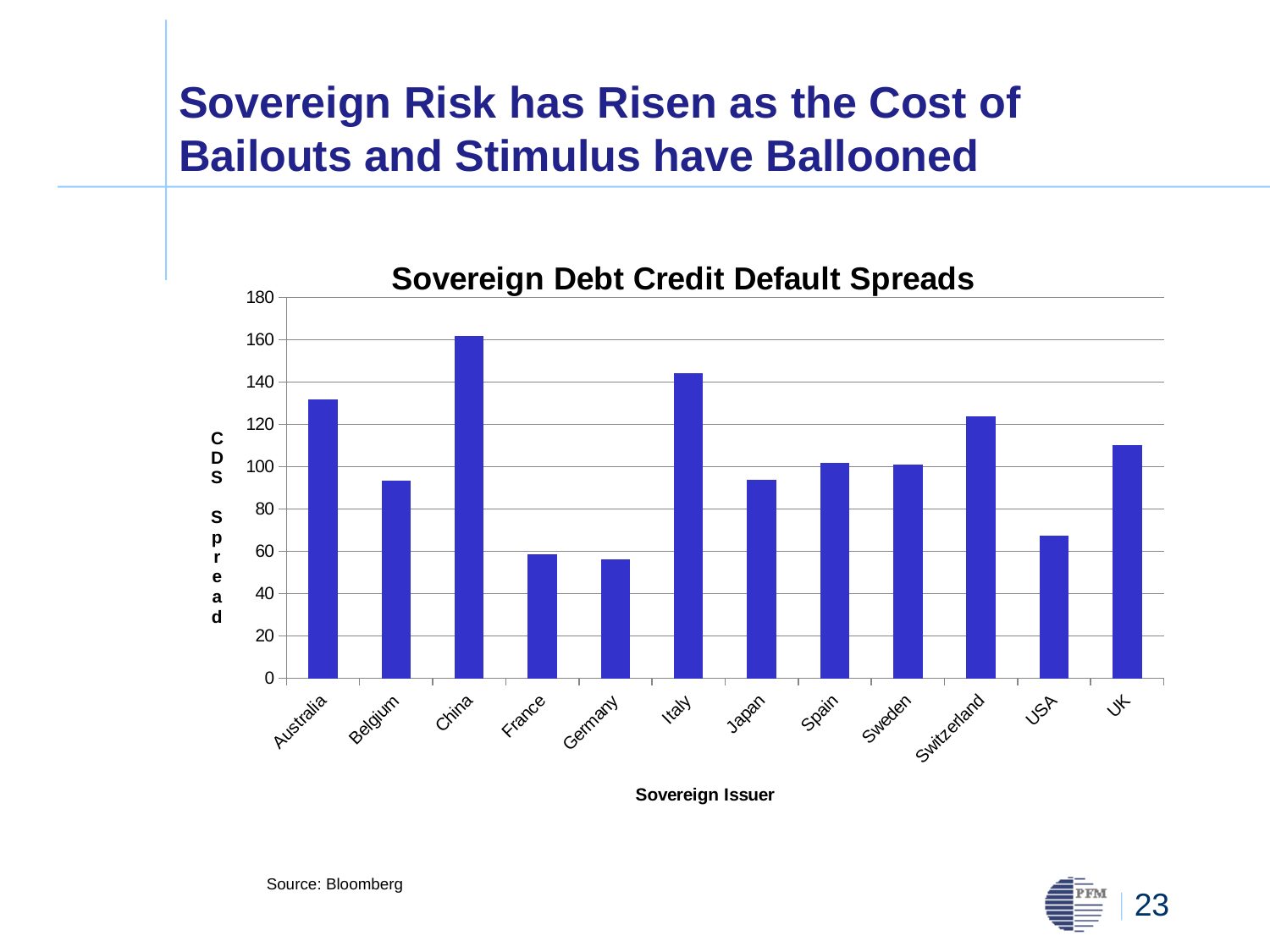
Is the CDS spread for USA greater or less than 80? less Is the CDS spread for Belgium greater or less than 100? less What is the title of the chart? Sovereign Debt Credit Default Spreads Is the CDS spread for China greater or less than 140? greater What kind of chart is shown on the slide? Bar chart Which sovereign issuer has the highest CDS spread? China Which has a higher CDS spread, Italy or Australia? Italy How many sovereign issuers are shown on the x axis? 12 Which has a higher CDS spread, Switzerland or USA? Switzerland